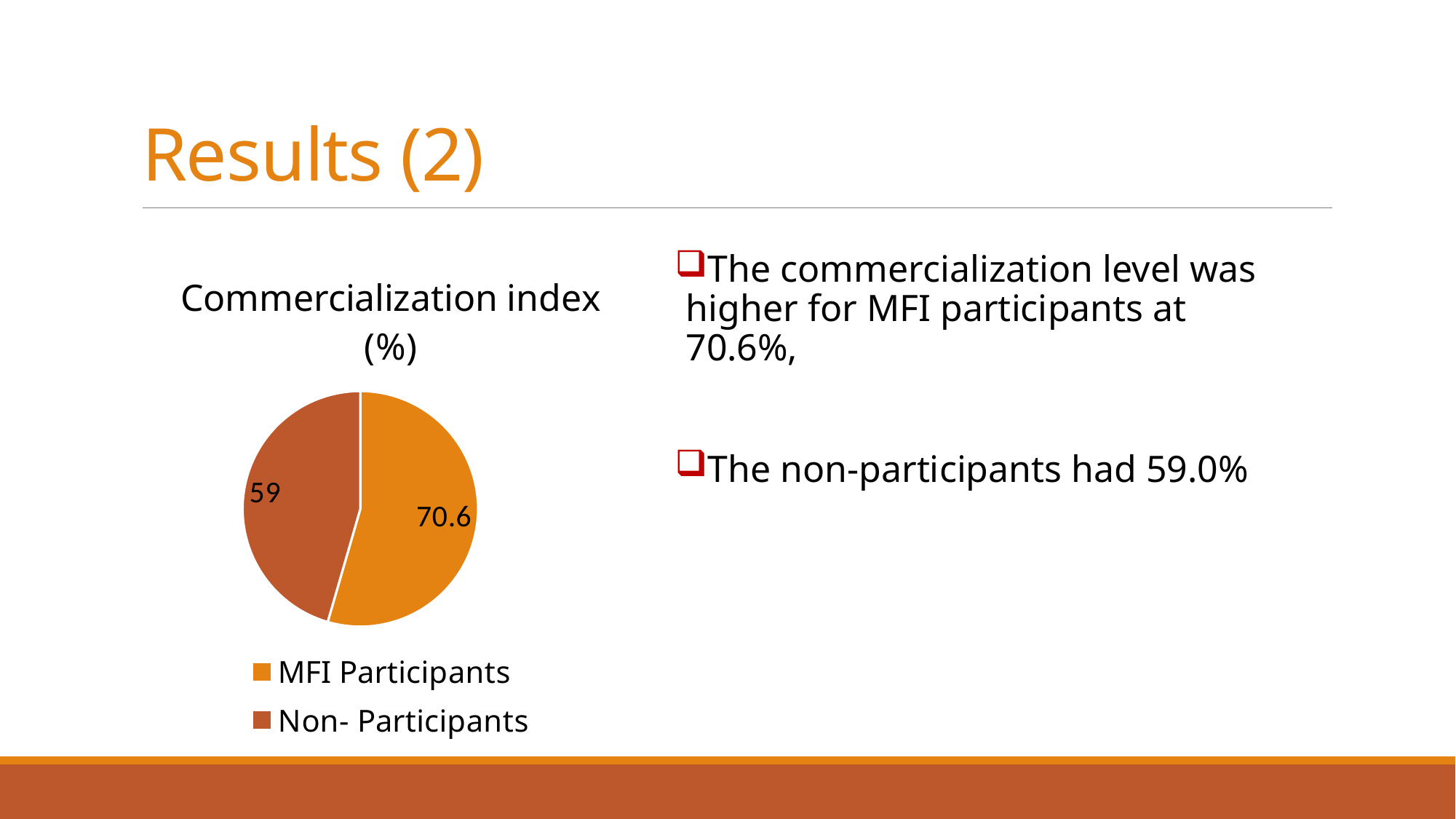
What kind of chart is shown on the slide? Pie chart What is the difference between the MFI Participants value and the Non- Participants value in the pie chart? 11.6 What is the title of the chart on the slide? Commercialization index (%) Which is larger in the pie chart, the value for MFI Participants or for Non- Participants? MFI Participants Which legend entry is shown in the lighter orange colour in the pie chart? MFI Participants What is the value for MFI Participants in the Commercialization index (%) pie chart? 70.6 How many entries does the legend of the pie chart list? 2 Which category has the largest slice in the Commercialization index (%) pie chart? MFI Participants What is the value for Non- Participants in the Commercialization index (%) pie chart? 59 How many categories does the Commercialization index (%) pie chart show? 2 Which category has the smallest slice in the Commercialization index (%) pie chart? Non- Participants